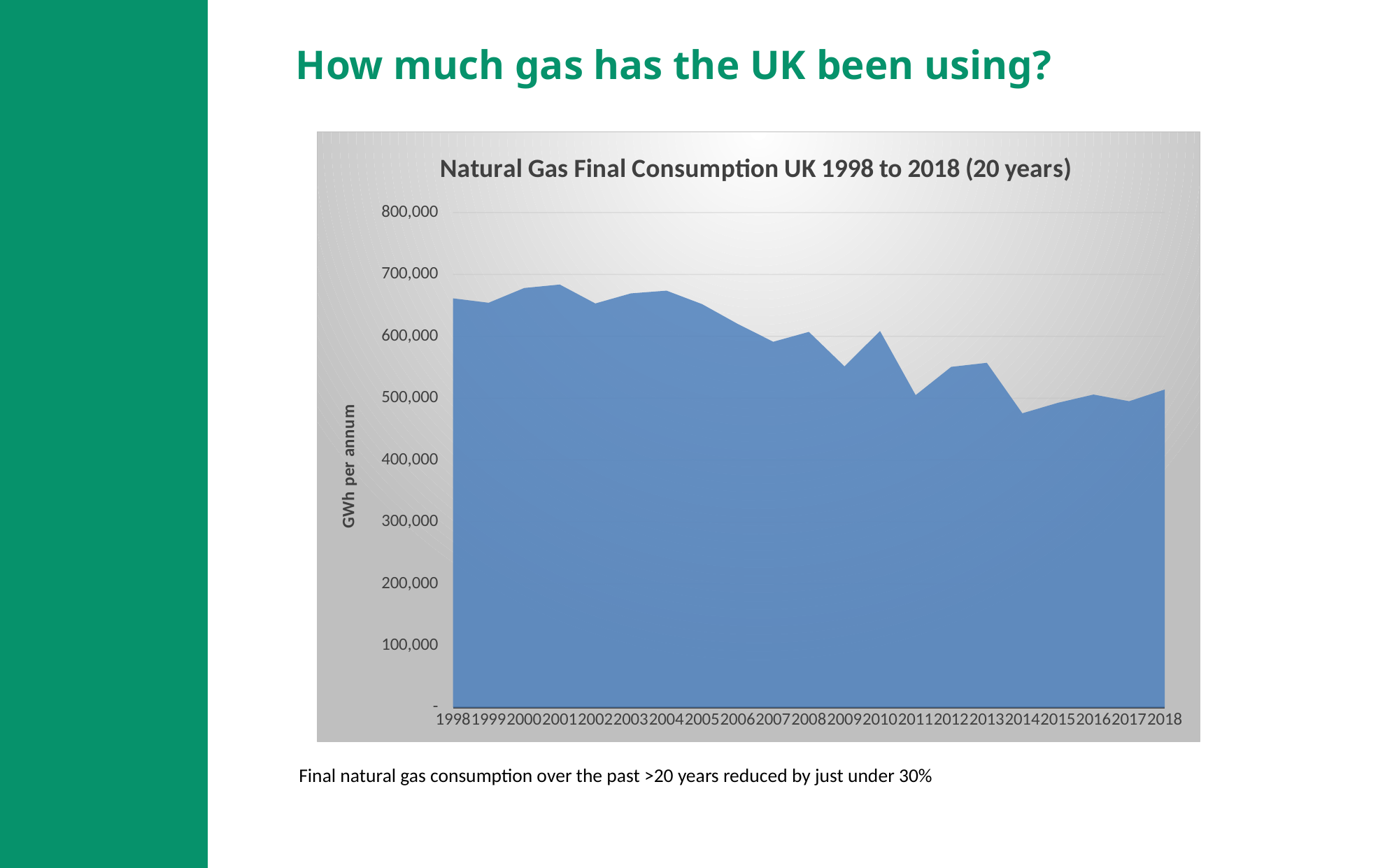
Is the value for 2001 greater or less than 700,000? less Is the value for 2013 greater or less than 500,000? greater Is the value for 1998 greater or less than 600,000? greater How many years are plotted along the x axis of the chart? 21 Overall, do the values rise or fall from 1998 to 2018? Fall Which year has the larger value, 2010 or 2011? 2010 What is the title of the chart? Natural Gas Final Consumption UK 1998 to 2018 (20 years) Which year has the larger value, 1998 or 2018? 1998 What is the label on the vertical axis of the chart? GWh per annum What type of chart is shown on the slide? Area chart